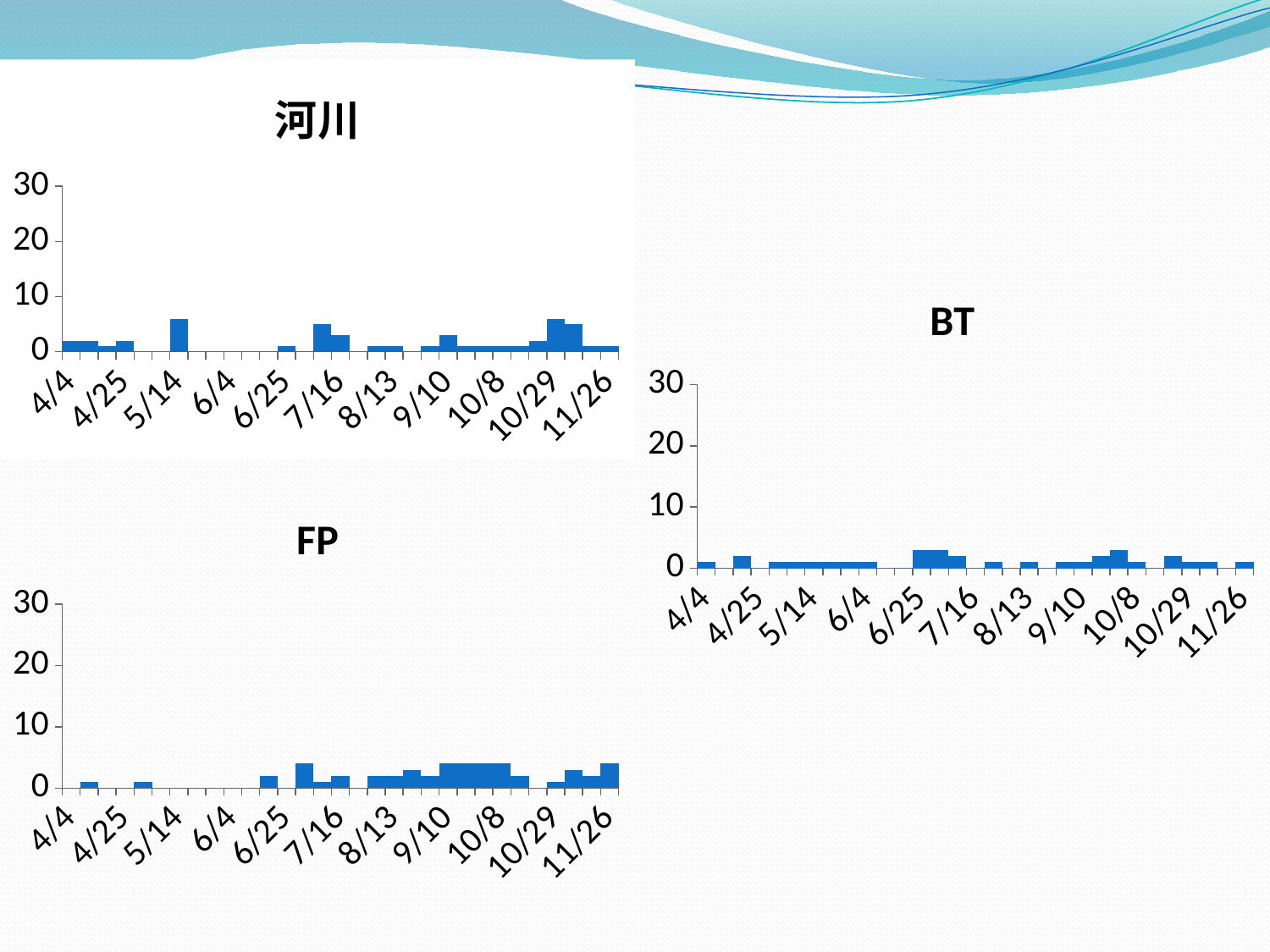
In the 河川 chart, is the value at 5/14 greater or less than 10? less In the BT chart, is the value at 10/8 greater or less than 10? less Is the tallest bar in the 河川 chart taller or shorter than the tallest bar in the BT chart? taller In the 河川 chart, is the tallest bar greater or less than 10? less What are the titles of the three charts on the slide? 河川, FP, BT How many date labels are shown on the x axis of the BT chart? 11 How many charts are shown on the slide? 3 What type of chart is the 河川 chart? bar chart Which of the three charts contains the tallest bar? 河川 What type of chart is the FP chart? bar chart What type of chart is the BT chart? bar chart